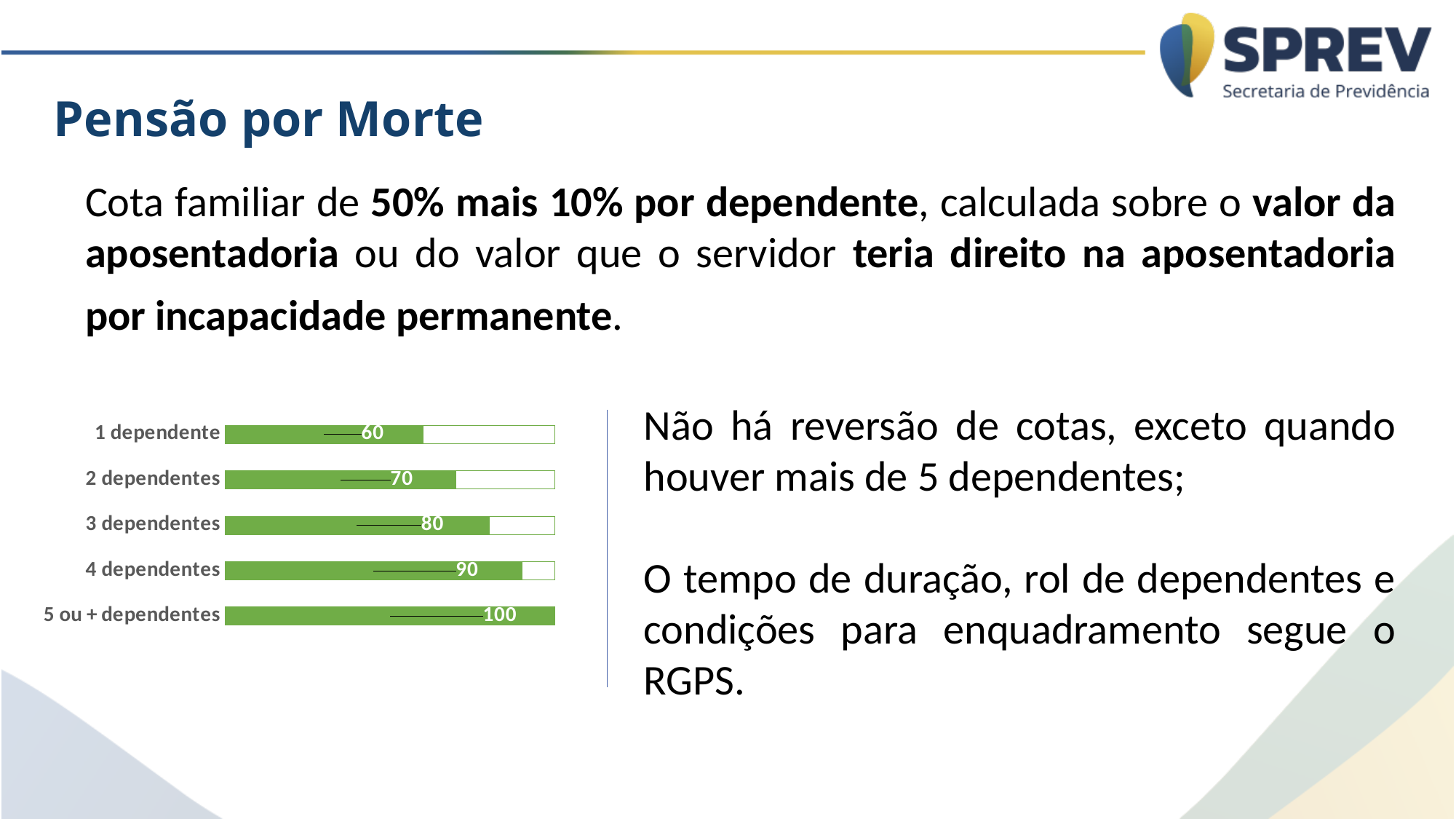
Which is larger, the value for 4 dependentes or the value for 2 dependentes? 4 dependentes What is the value for 1 dependente? 60 What is the value for 4 dependentes? 90 Which category has the highest value? 5 ou + dependentes What is the value for 5 ou + dependentes? 100 What kind of chart is shown on the slide? bar chart Which category has the lowest value? 1 dependente What is the difference between the values for 2 dependentes and 1 dependente? 10 What is the difference between the values for 5 ou + dependentes and 3 dependentes? 20 What is the value for 3 dependentes? 80 Do the values increase or decrease as the number of dependents goes from 1 to 5 ou +? increase How many categories does the chart show? 5